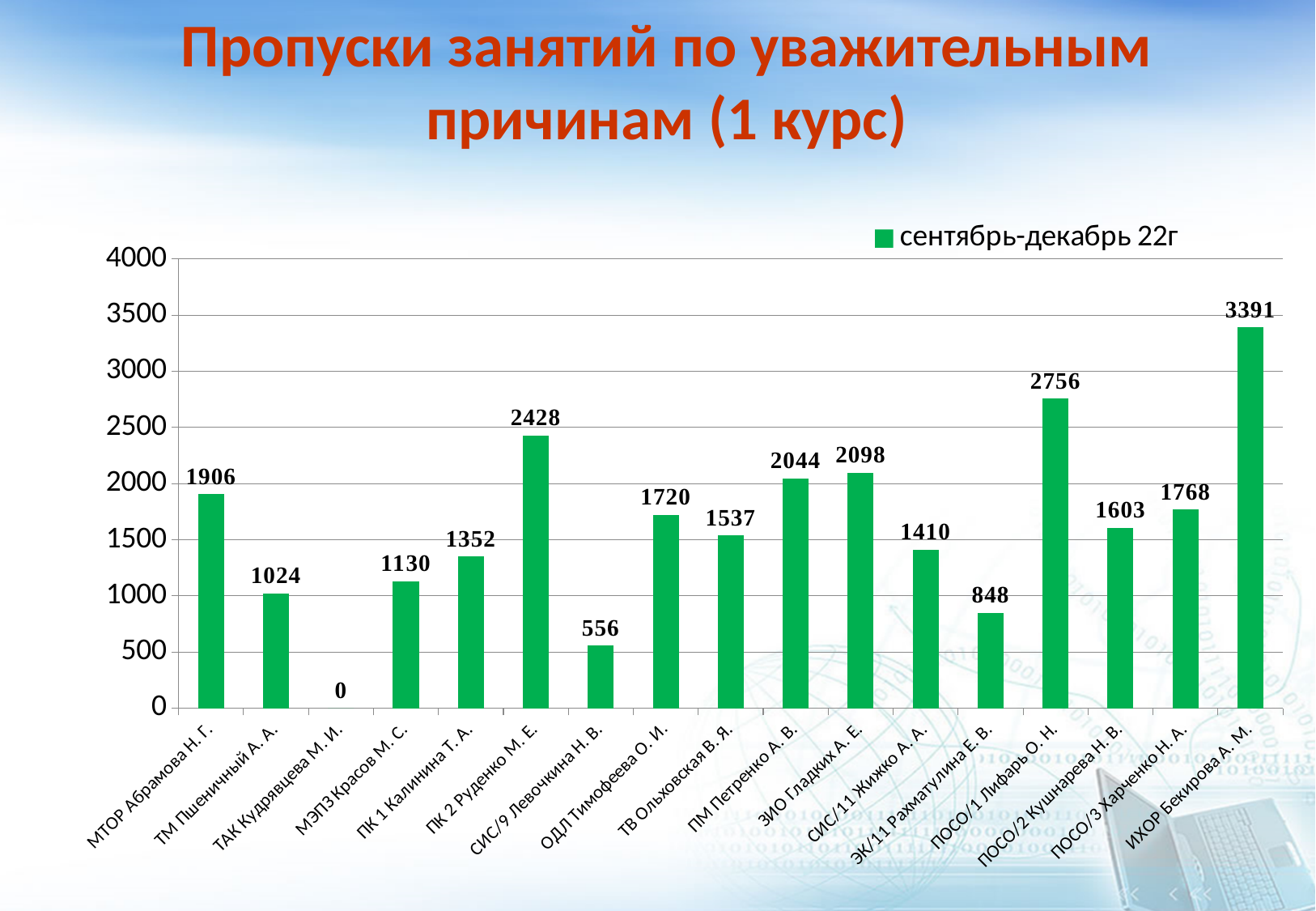
Which is larger, the value for ПМ Петренко А. В. or the value for ОДЛ Тимофеева О. И.? ПМ Петренко А. В. What is the legend entry for the series shown? сентябрь-декабрь 22г What kind of chart is shown on the slide? bar chart Is the value for СИС/9 Левочкина Н. В. greater or less than 1000? less What is the value for ЭК/11 Рахматулина Е. В.? 848 What is the value for ПОСО/1 Лифарь О. Н.? 2756 How many categories are shown on the x axis? 17 What is the difference between the values for ИХОР Бекирова А. М. and ПОСО/1 Лифарь О. Н.? 635 Which category has the lowest value? ТАК Кудрявцева М. И. What is the value for ПК 2 Руденко М. Е.? 2428 What is the difference between the values for ПК 2 Руденко М. Е. and МТОР Абрамова Н. Г.? 522 Which category has the highest value? ИХОР Бекирова А. М.